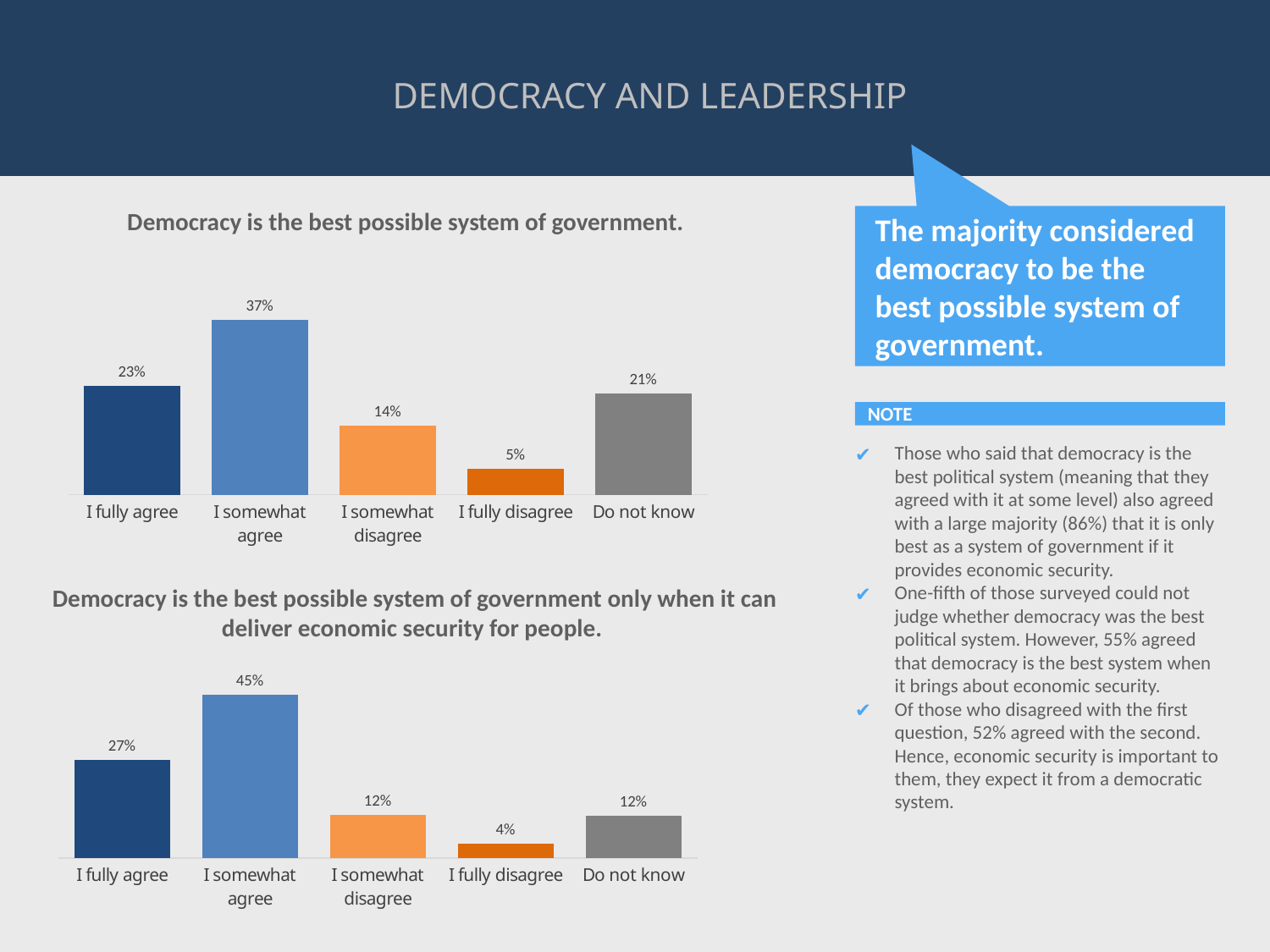
In the lower chart ("...only when it can deliver economic security for people."), what is the value for "I fully agree"? 27% In the chart titled "Democracy is the best possible system of government.", what is the value for "I somewhat agree"? 37% In the lower chart ("...only when it can deliver economic security for people."), which category has the highest value? I somewhat agree In the lower chart ("...only when it can deliver economic security for people."), which is larger: "I fully agree" or "Do not know"? I fully agree In the chart titled "Democracy is the best possible system of government.", what is the value for "Do not know"? 21% In the chart titled "Democracy is the best possible system of government.", what is the difference between "I fully agree" and "I somewhat disagree"? 9% In the chart titled "Democracy is the best possible system of government.", which category has the lowest value? I fully disagree In the lower chart ("...only when it can deliver economic security for people."), what is the value for "I fully disagree"? 4% In the lower chart ("...only when it can deliver economic security for people."), what is the difference between "I somewhat agree" and "I fully agree"? 18% What colour is the "I fully disagree" bar in the upper chart? Dark orange What type of chart is the upper chart on the slide? Bar chart In the chart titled "Democracy is the best possible system of government.", how many categories are shown? 5